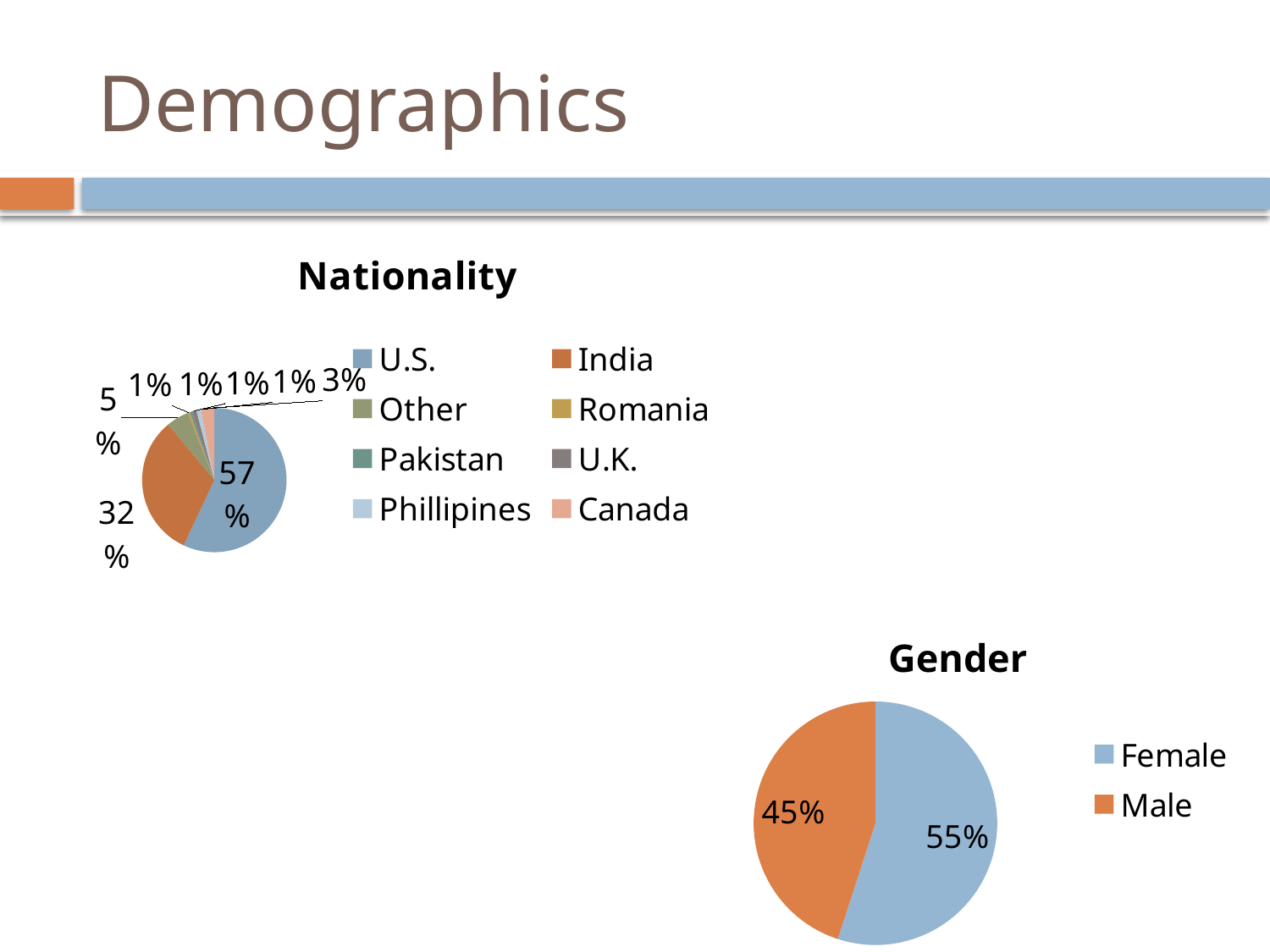
In the Gender chart, what share of the pie is Male? 45% In the Gender chart, what is the difference between the Female and Male shares? 10% In the Nationality chart, what is the difference between the U.S. share and the India share? 25% In the Nationality chart, what share of the pie is Other? 5% In the Gender chart, what share of the pie is Female? 55% In the Nationality chart, what share of the pie is U.S.? 57% In the Nationality chart, what share of the pie is India? 32% What kind of chart is the Nationality chart? Pie chart In the Nationality chart, which nationality has the largest share? U.S. In the Gender chart, which gender has the larger share? Female In the Nationality chart, which is larger, the share for India or the share for Other? India In the Nationality chart, how many categories does the legend list? 8